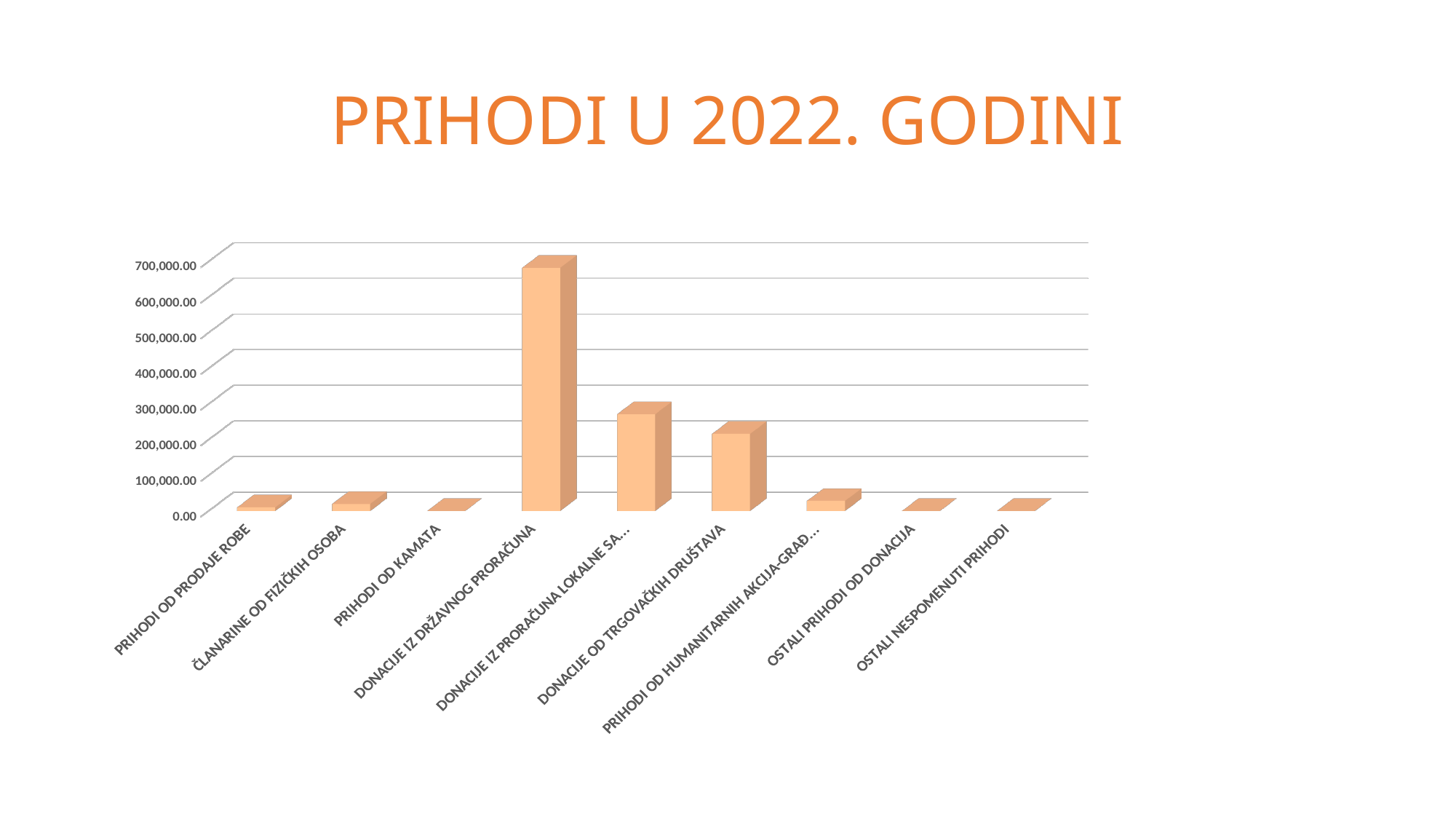
Is the value for PRIHODI OD HUMANITARNIH AKCIJA-GRAĐ... greater or less than 100,000.00? less Which is larger, the value for DONACIJE IZ DRŽAVNOG PRORAČUNA or the value for DONACIJE OD TRGOVAČKIH DRUŠTAVA? DONACIJE IZ DRŽAVNOG PRORAČUNA Is the value for DONACIJE IZ PRORAČUNA LOKALNE SA... greater or less than 200,000.00? greater Is the value for DONACIJE OD TRGOVAČKIH DRUŠTAVA greater or less than 300,000.00? less What colour are the bars in the chart? orange What kind of chart is shown on the slide? bar chart Which category has the highest value in the chart? DONACIJE IZ DRŽAVNOG PRORAČUNA Which is larger, the value for DONACIJE IZ PRORAČUNA LOKALNE SA... or the value for DONACIJE OD TRGOVAČKIH DRUŠTAVA? DONACIJE IZ PRORAČUNA LOKALNE SA... How many categories are shown on the x axis of the chart? 9 What is the title of the chart? PRIHODI U 2022. GODINI